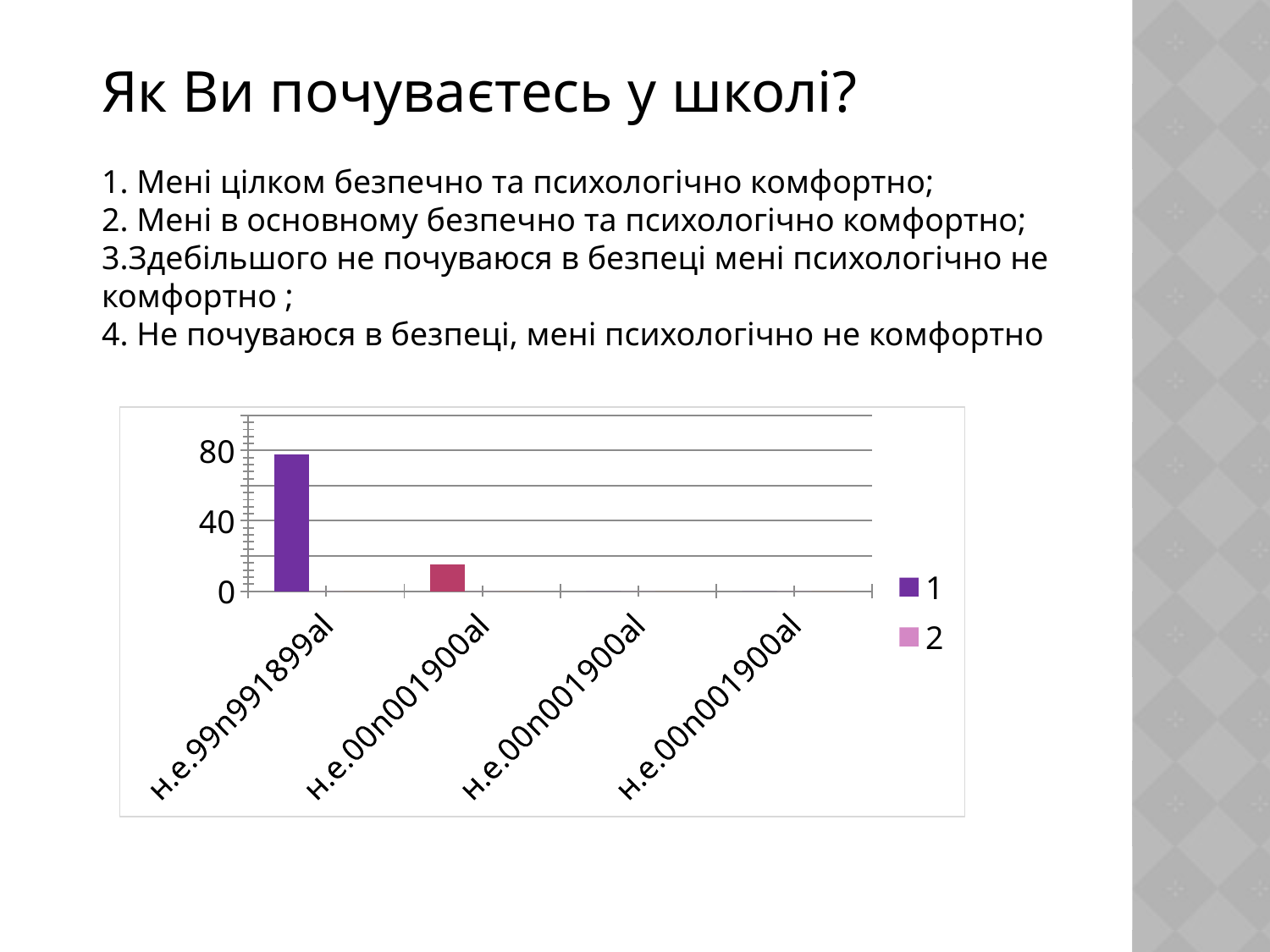
Is the value of the bar for the first category greater or less than 40? greater How many series does the chart legend list? 2 What kind of chart is shown on the slide? bar chart Is the value of the bar for the second category greater or less than 40? less What are the entries listed in the chart legend? 1 and 2 Which category has the tallest bar in the chart? the first category Which is larger: the bar for the first category or the bar for the second category? the first category What is the highest value labelled on the vertical axis of the chart? 80 How many categories are shown along the x axis of the chart? 4